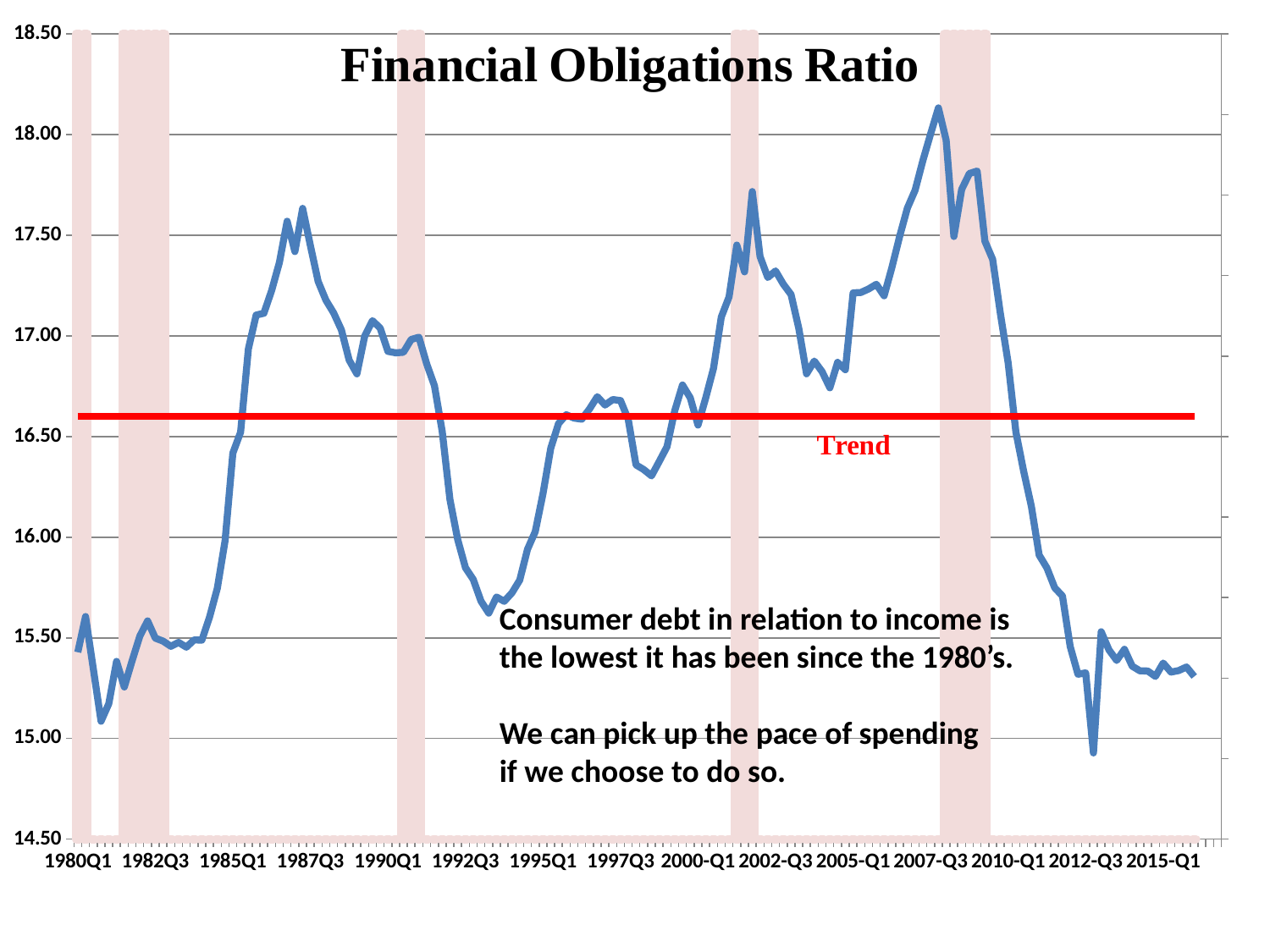
Is the value for 2007-Q3 greater or less than 17.50? greater Is the value for 2015-Q1 greater or less than 16.00? less What kind of chart is shown on the slide? line chart Is the value for 1992Q3 greater or less than 16.00? less Does the line rise or fall between 2007-Q3 and 2012-Q3? fall What does the horizontal red line on the chart represent? Trend How many labels are shown on the x axis? 15 What is the title of the chart? Financial Obligations Ratio Around which x-axis label does the line reach its highest point? 2007-Q3